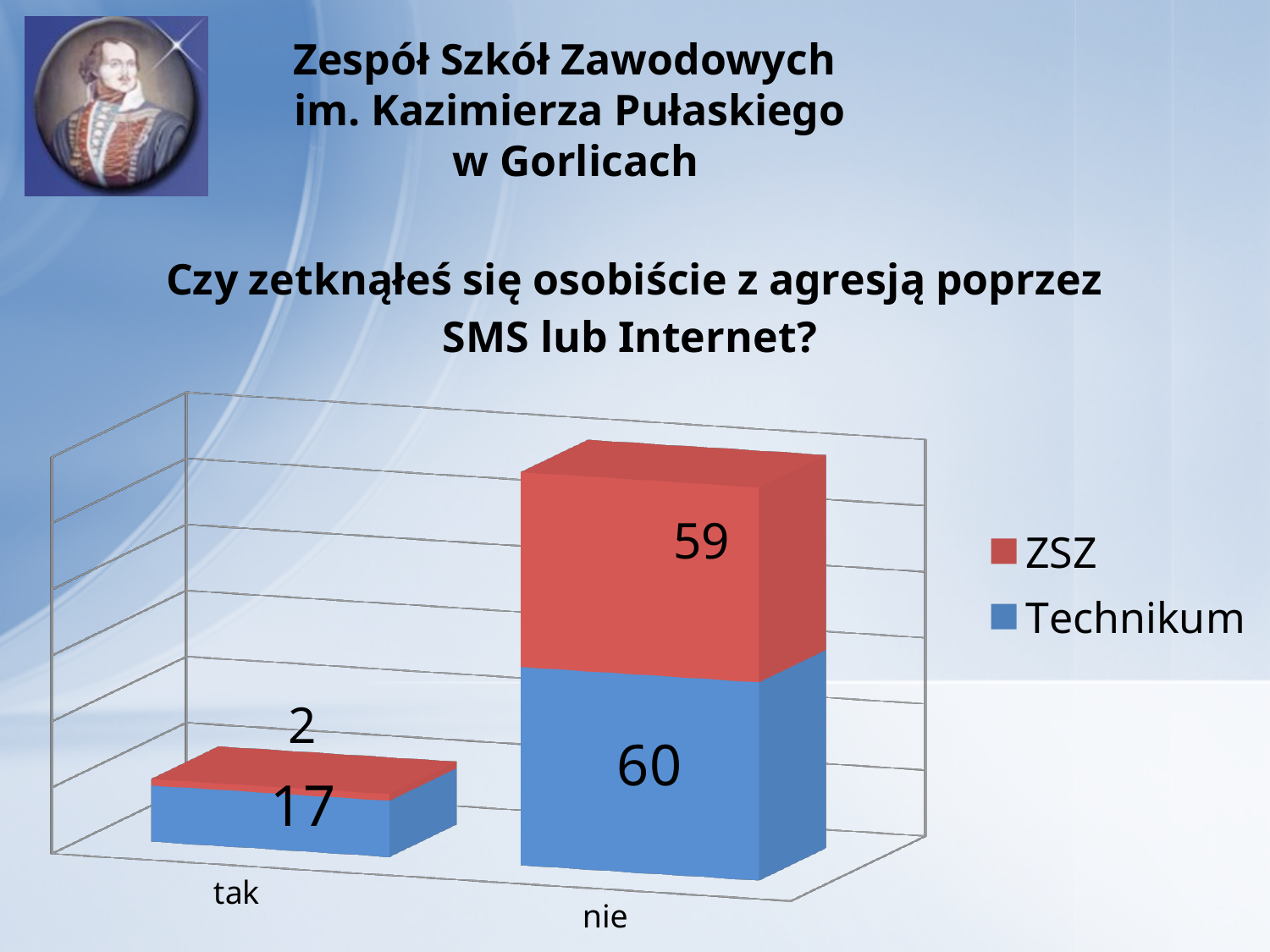
How many categories are shown on the x axis? 2 What kind of chart is shown on the slide? Stacked bar chart Which category has the higher ZSZ value, "tak" or "nie"? nie What is the total of the stacked bar for "nie"? 119 What is the difference between the Technikum values for "nie" and "tak"? 43 What is the value for Technikum in the "nie" category? 60 How many series does the legend list? 2 What is the value for Technikum in the "tak" category? 17 Which colour represents the ZSZ series in the legend? Red What is the total of the stacked bar for "tak"? 19 What is the value for ZSZ in the "tak" category? 2 What is the value for ZSZ in the "nie" category? 59